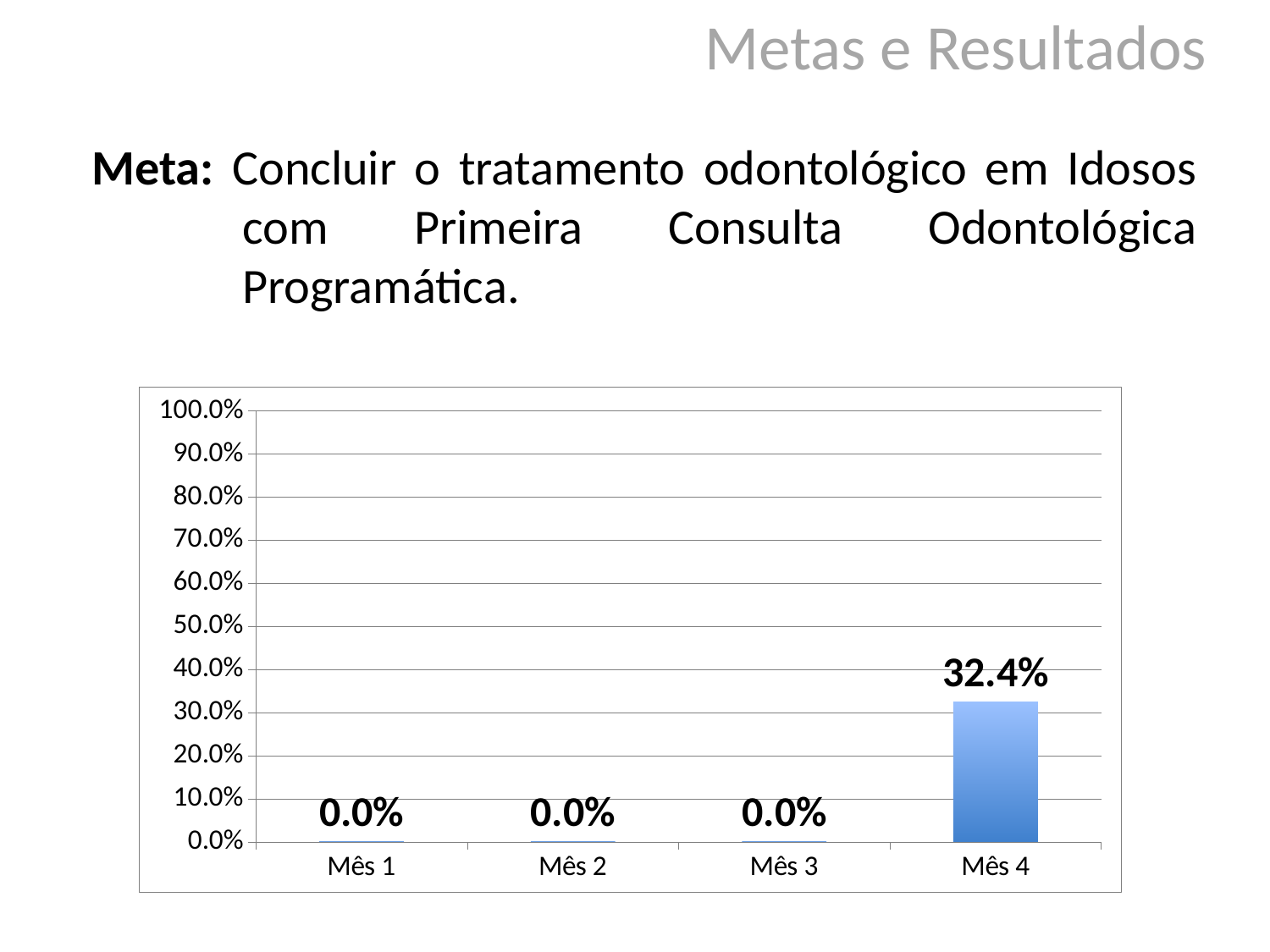
What is the value for Mês 3? 0.0% Do the values rise or fall from Mês 3 to Mês 4? rise Which is larger, the value for Mês 2 or the value for Mês 4? Mês 4 What is the highest value shown on the y axis? 100.0% How many months have a value of 0.0%? 3 How many months are shown on the x axis? 4 Which month has the highest value? Mês 4 What kind of chart is shown on the slide? bar chart What is the value for Mês 4? 32.4% Is the value for Mês 4 greater or less than 50.0%? less What is the value for Mês 1? 0.0% What is the difference between the values for Mês 4 and Mês 3? 32.4%